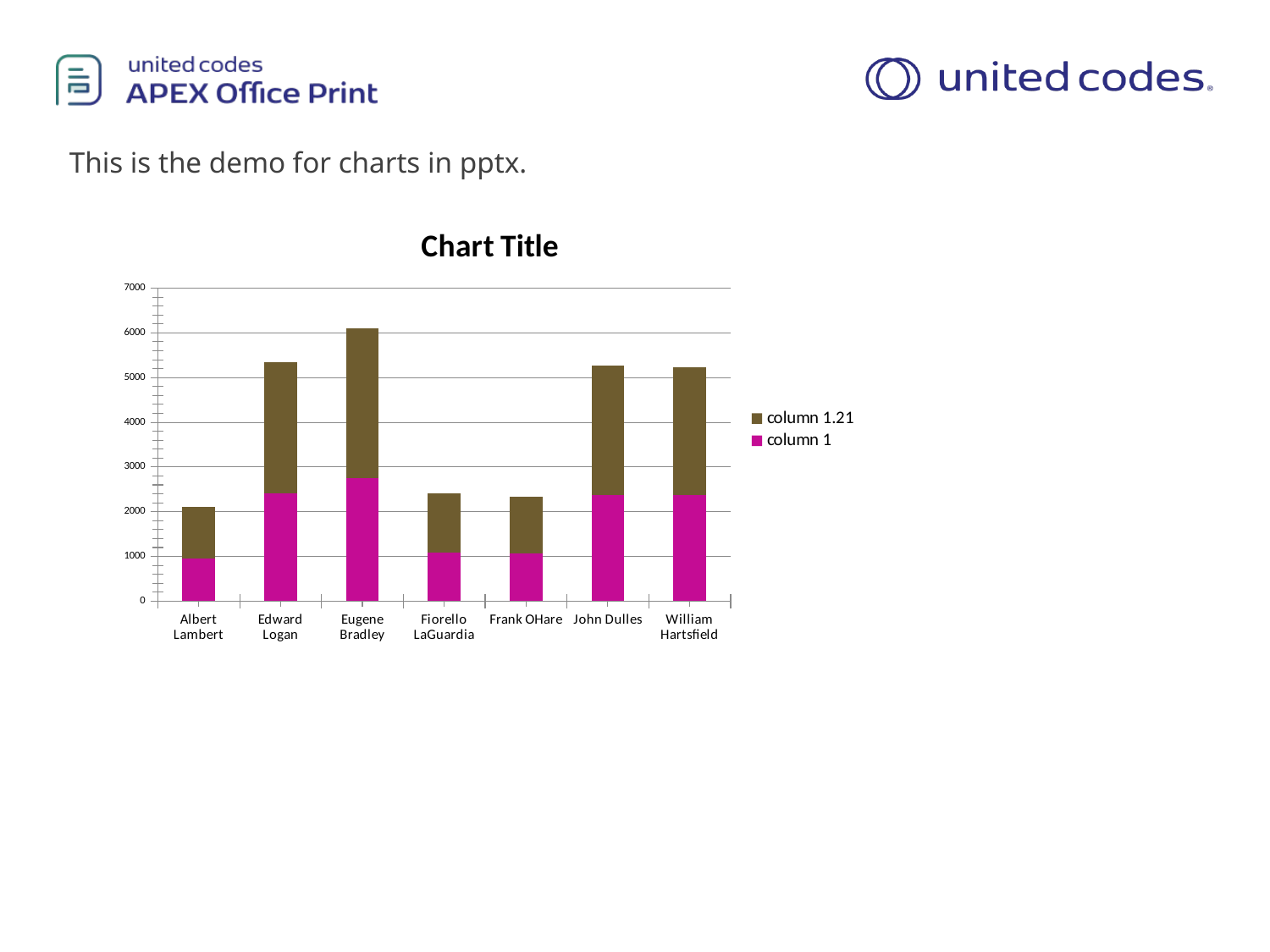
Is the column 1 value for Eugene Bradley greater or less than 2000? greater What kind of chart is shown on the slide? stacked bar chart Is the total stacked value for Edward Logan greater or less than 5000? greater What is the title of the chart? Chart Title Which series is shown in magenta in the chart? column 1 Is the total stacked value for Eugene Bradley greater or less than 5000? greater How many series does the chart's legend list? 2 Which has the larger total stacked value, Edward Logan or Fiorello LaGuardia? Edward Logan How many categories are shown on the x axis of the chart? 7 Which category has the tallest stacked bar in the chart? Eugene Bradley